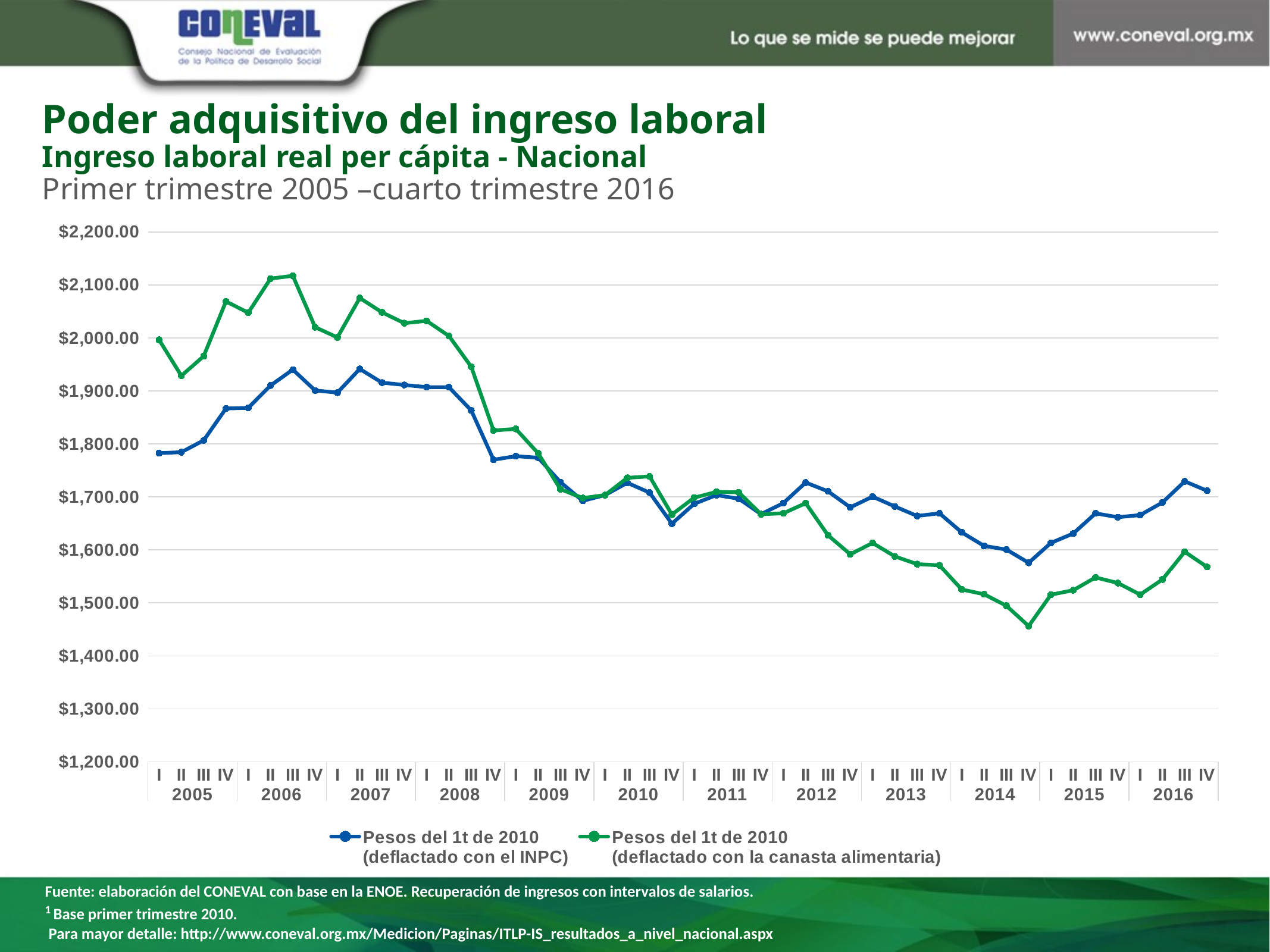
In quarter I of 2005, which series has the higher value: the one deflated with the INPC or the one deflated with the canasta alimentaria? Deflactado con la canasta alimentaria Is the value of the 'Pesos del 1t de 2010 (deflactado con el INPC)' series in quarter II of 2007 greater or less than $1,900.00? greater How many series does the legend list? 2 In which quarter does the 'Pesos del 1t de 2010 (deflactado con la canasta alimentaria)' series reach its lowest value? IV 2014 Is the value of the 'Pesos del 1t de 2010 (deflactado con el INPC)' series in quarter I of 2005 greater or less than $1,800.00? less Does the 'Pesos del 1t de 2010 (deflactado con la canasta alimentaria)' series generally rise or fall from quarter I of 2012 to quarter IV of 2014? Fall How many quarterly data points does each series have? 48 What colour is the line for the series deflated with the INPC? Blue How many years are labelled along the x axis? 12 What kind of chart is shown on the slide? Line chart Is the value of the 'Pesos del 1t de 2010 (deflactado con la canasta alimentaria)' series in quarter IV of 2014 greater or less than $1,500.00? less